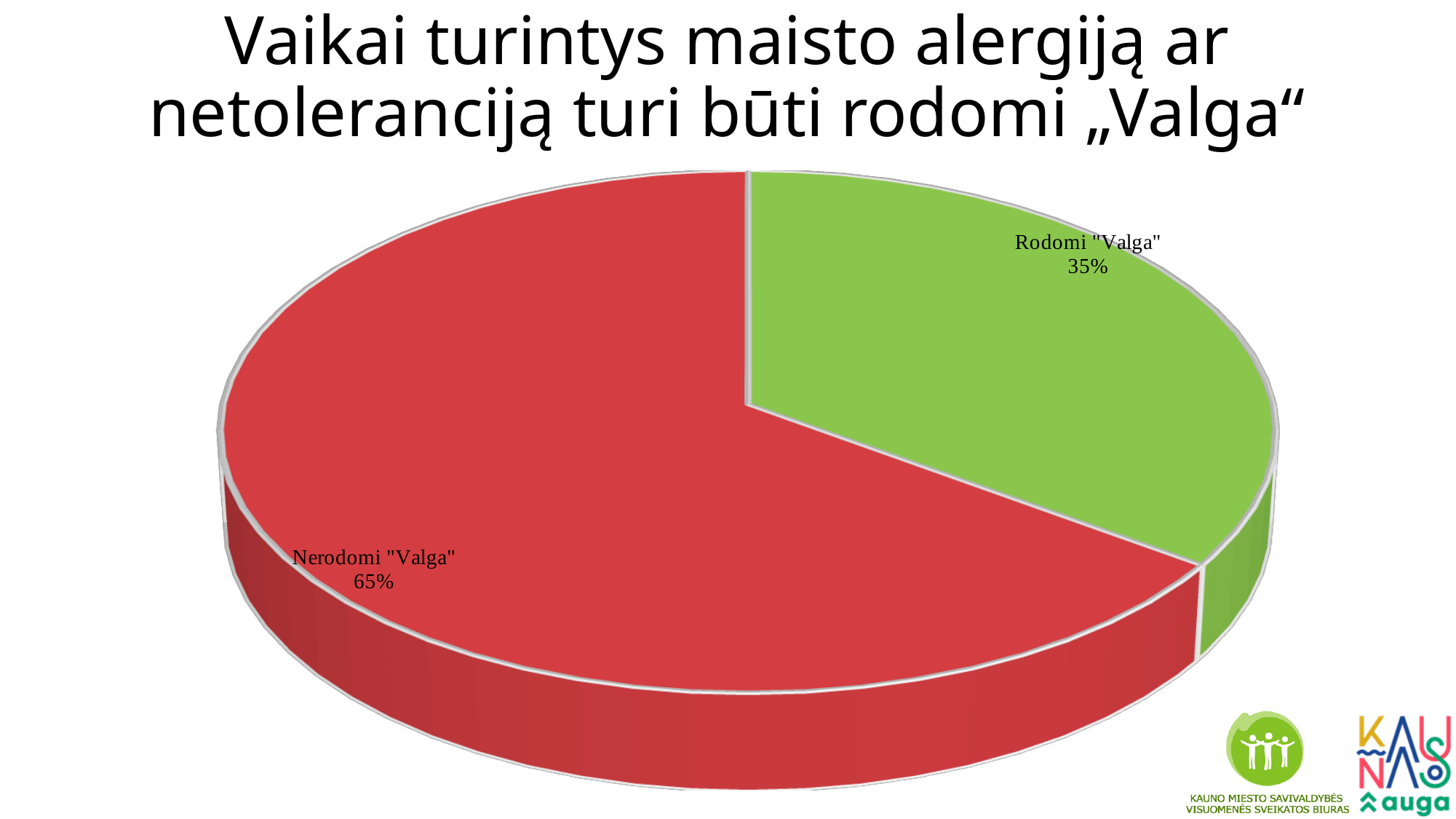
What share of the pie does the Rodomi "Valga" slice represent? 35% What kind of chart is shown on the slide? pie chart What percentage is shown for the slice labelled Nerodomi "Valga"? 65% How many slices does the pie chart have? 2 Which is larger, the Rodomi "Valga" slice or the Nerodomi "Valga" slice? Nerodomi "Valga" What is the difference in percentage points between the Nerodomi "Valga" slice and the Rodomi "Valga" slice? 30 Which slice of the pie is the largest? Nerodomi "Valga" What percentage is shown for the slice labelled Rodomi "Valga"? 35% What colour is the Rodomi "Valga" slice? green What colour is the Nerodomi "Valga" slice? red Which slice of the pie is the smallest? Rodomi "Valga"